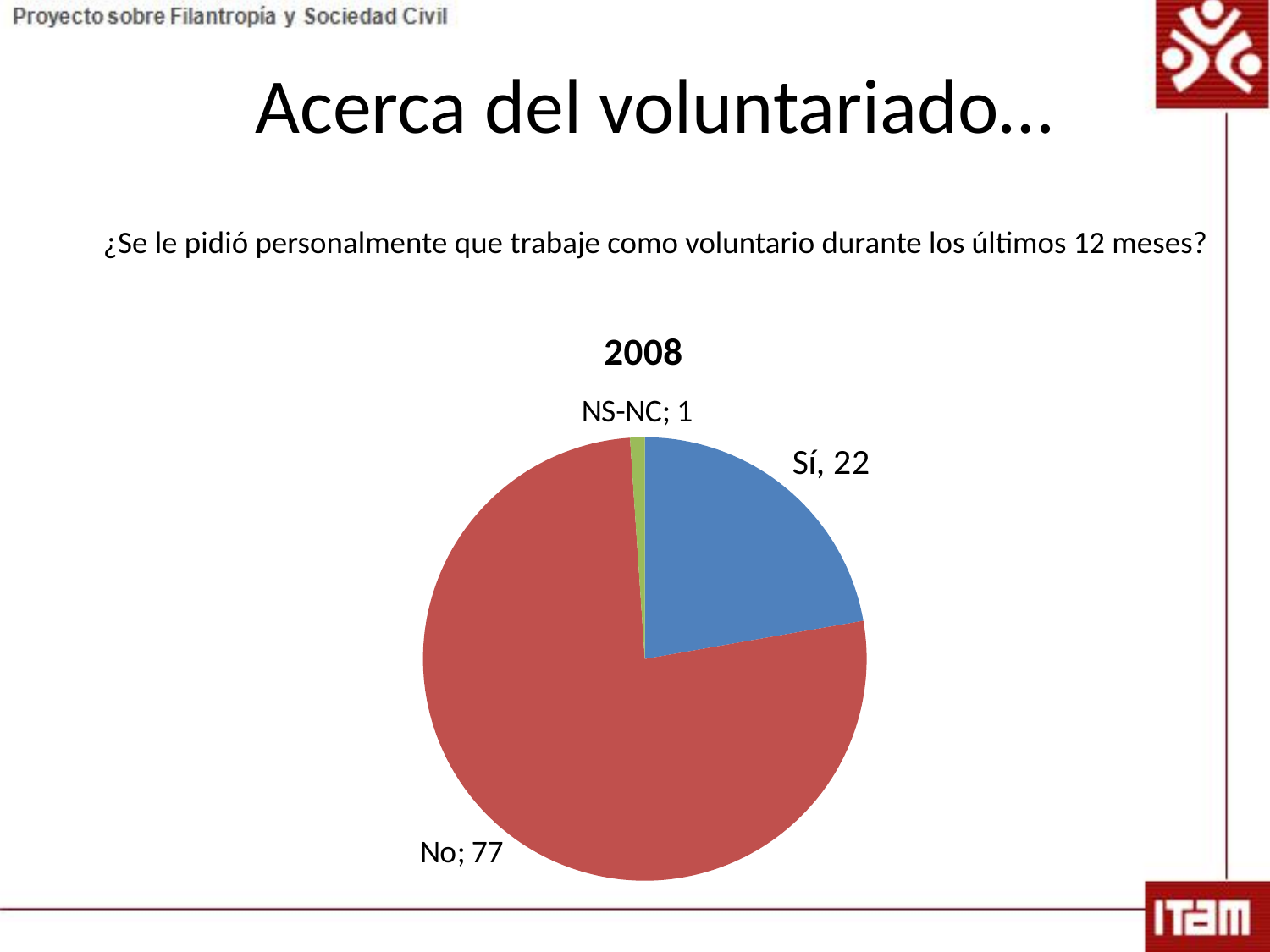
What is the value for the 'Sí' slice? 22 What is the total of all the slice values shown? 100 Which is larger, the value for 'Sí' or the value for 'NS-NC'? Sí What is the value for the 'No' slice? 77 What type of chart is shown on the slide? pie chart What colour is the 'No' slice? red What is the difference between the 'No' and 'Sí' values? 55 Which category has the largest slice? No How many slices does the pie chart have? 3 Which category has the smallest slice? NS-NC What is the title of the pie chart? 2008 What is the value for the 'NS-NC' slice? 1